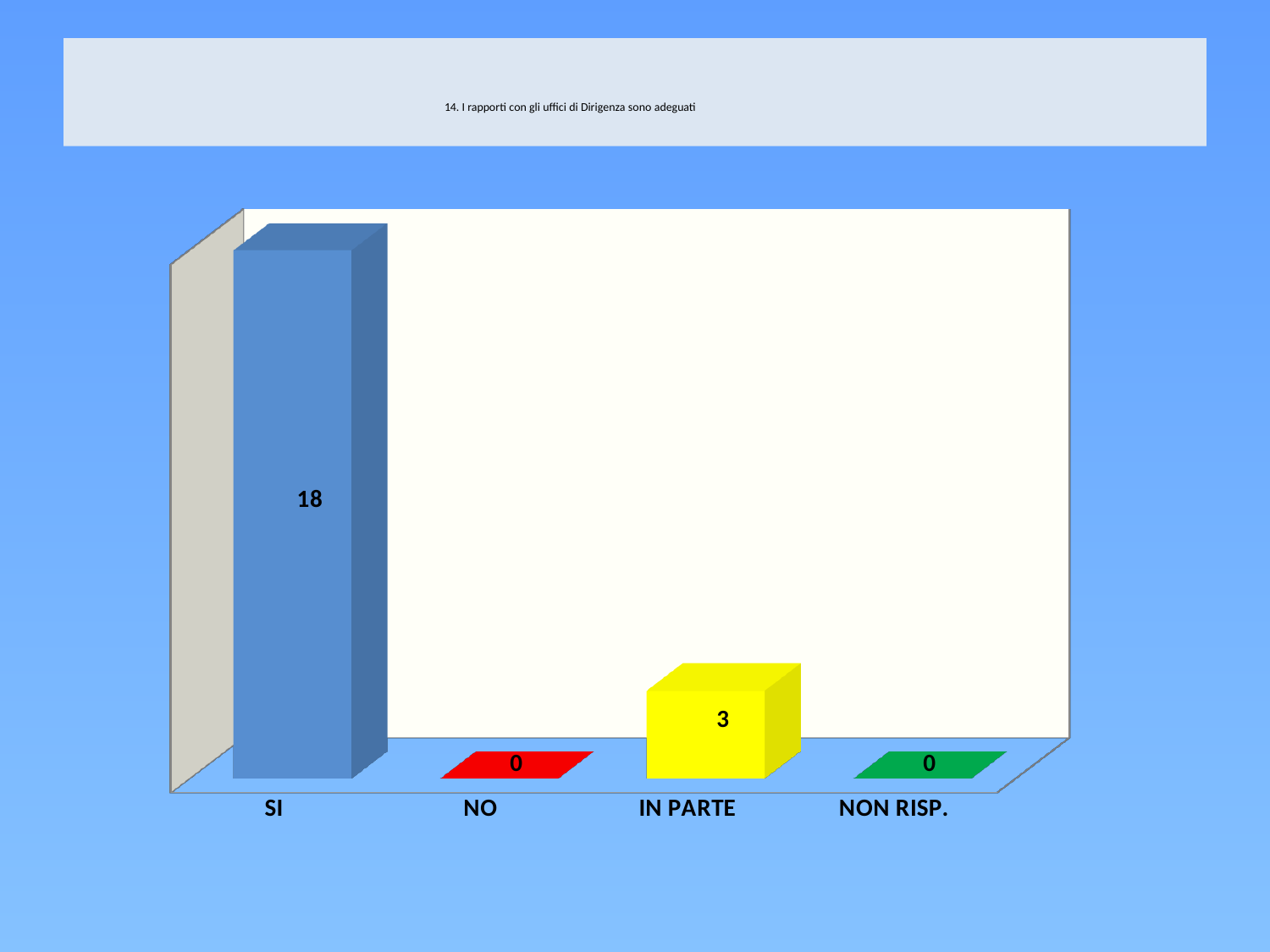
Which category has the highest value? SI What is the value for IN PARTE? 3 What is the total of all the values shown in the chart? 21 What is the title of the slide above the chart? 14. I rapporti con gli uffici di Dirigenza sono adeguati Which is larger, the value for SI or the value for IN PARTE? SI What is the value for NO? 0 What colour is the bar for IN PARTE? yellow What kind of chart is shown on the slide? bar chart What is the value for NON RISP.? 0 How many categories are shown on the x axis? 4 What is the difference between the values for SI and IN PARTE? 15 What is the value for SI? 18